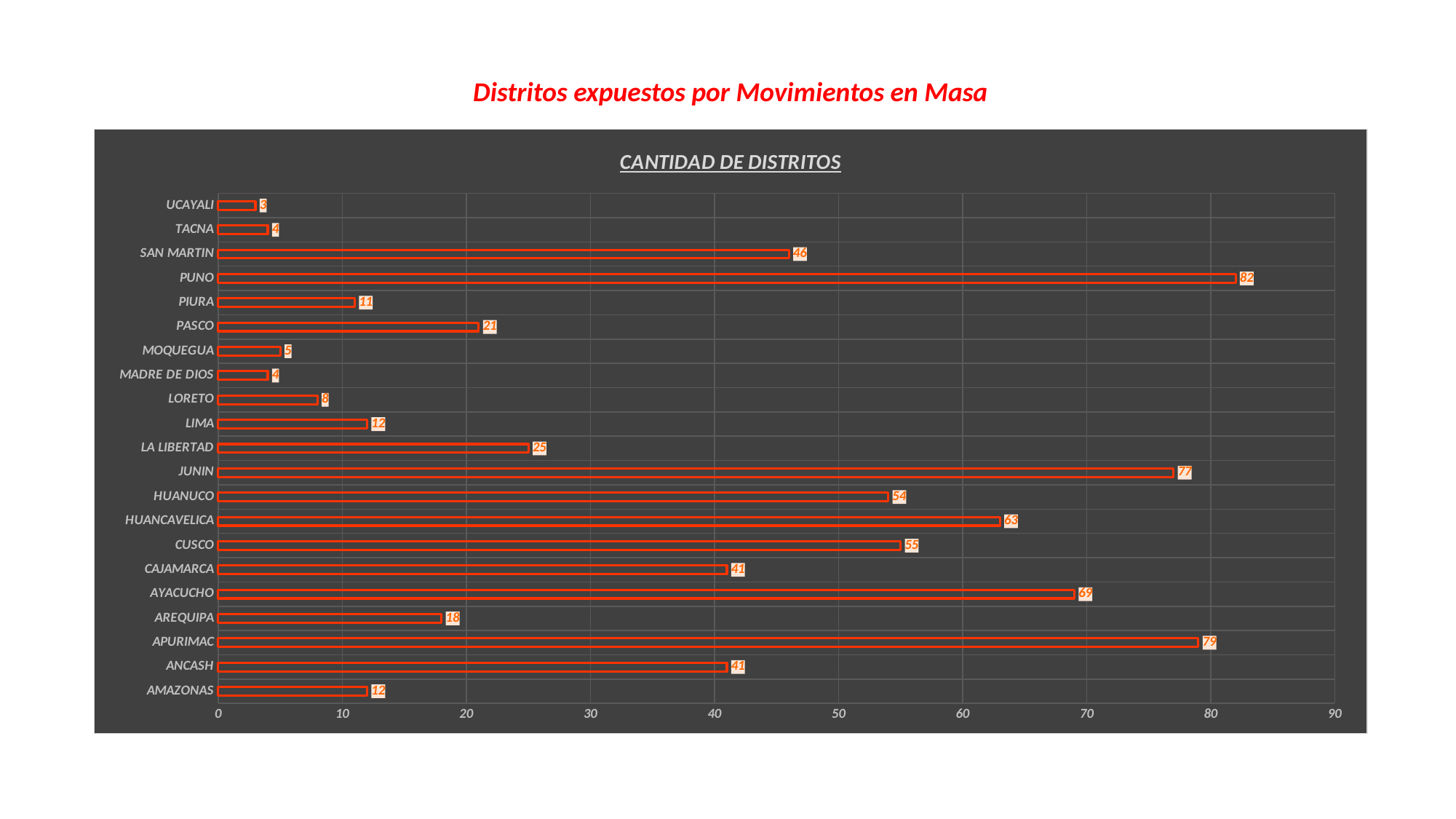
How many categories are shown in the chart? 21 What is the value for LA LIBERTAD? 25 Is the value for PASCO greater or less than 20? greater What is the value for PUNO? 82 Which category has the highest value? PUNO What kind of chart is shown on the slide? bar chart What is the difference between the values for APURIMAC and AYACUCHO? 10 What is the difference between the values for PUNO and JUNIN? 5 What is the value for HUANCAVELICA? 63 Which is larger, the value for SAN MARTIN or the value for CAJAMARCA? SAN MARTIN What is the title of the chart? CANTIDAD DE DISTRITOS Which category has the lowest value? UCAYALI